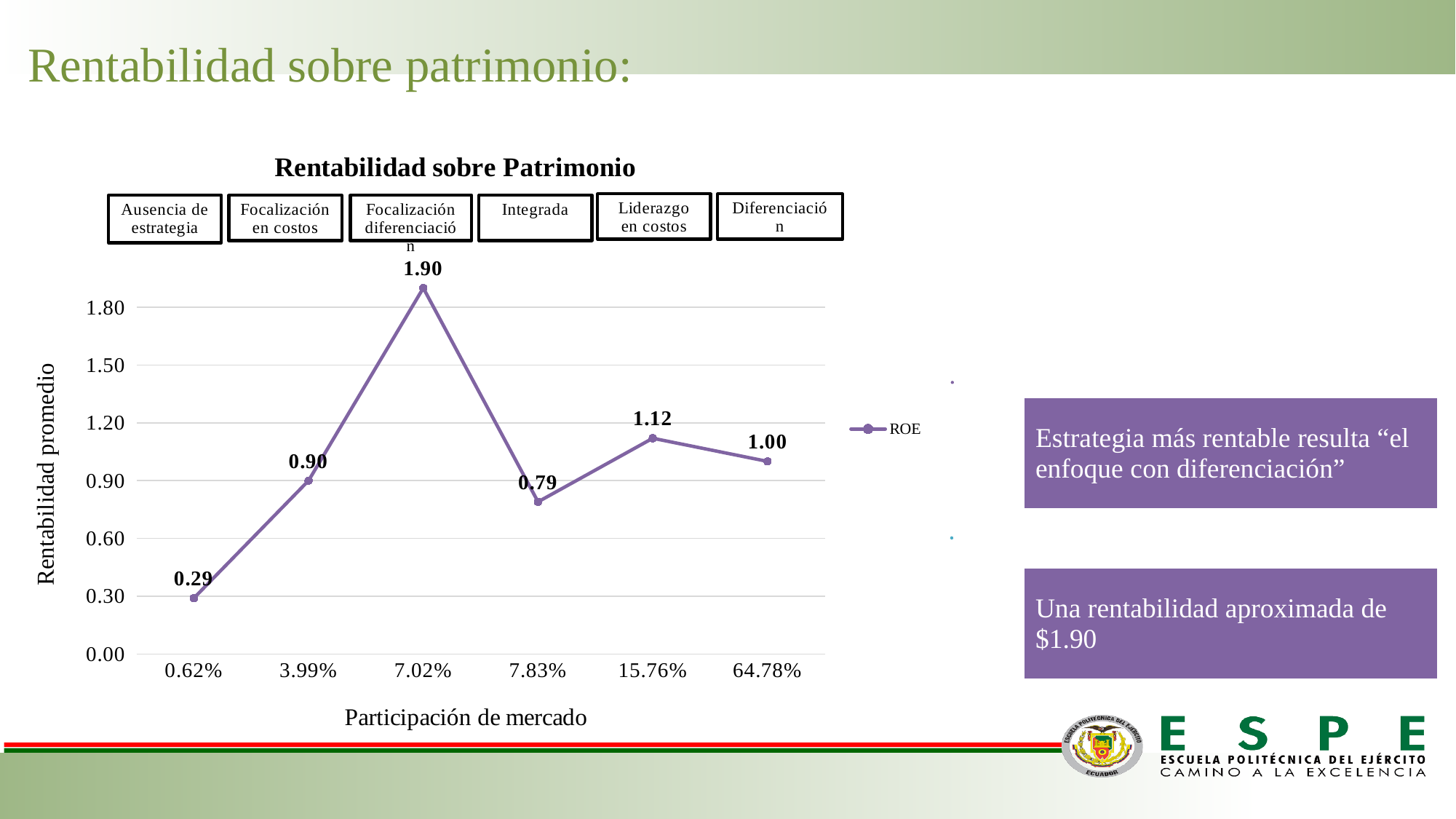
What is the label of the x axis? Participación de mercado Which market share point has the lowest ROE? 0.62% What is the difference between the ROE at 7.02% and the ROE at 7.83%? 1.11 Which market share point has the highest ROE? 7.02% What is the ROE value at the 7.02% market share point? 1.90 Which is larger, the ROE at 15.76% or the ROE at 64.78%? 15.76% How many series does the legend list? 1 What kind of chart is shown on the slide? Line chart What is the ROE value at the 15.76% market share point? 1.12 What is the ROE value at the 0.62% market share point? 0.29 How many data points are plotted on the ROE line? 6 What is the title of the chart? Rentabilidad sobre Patrimonio